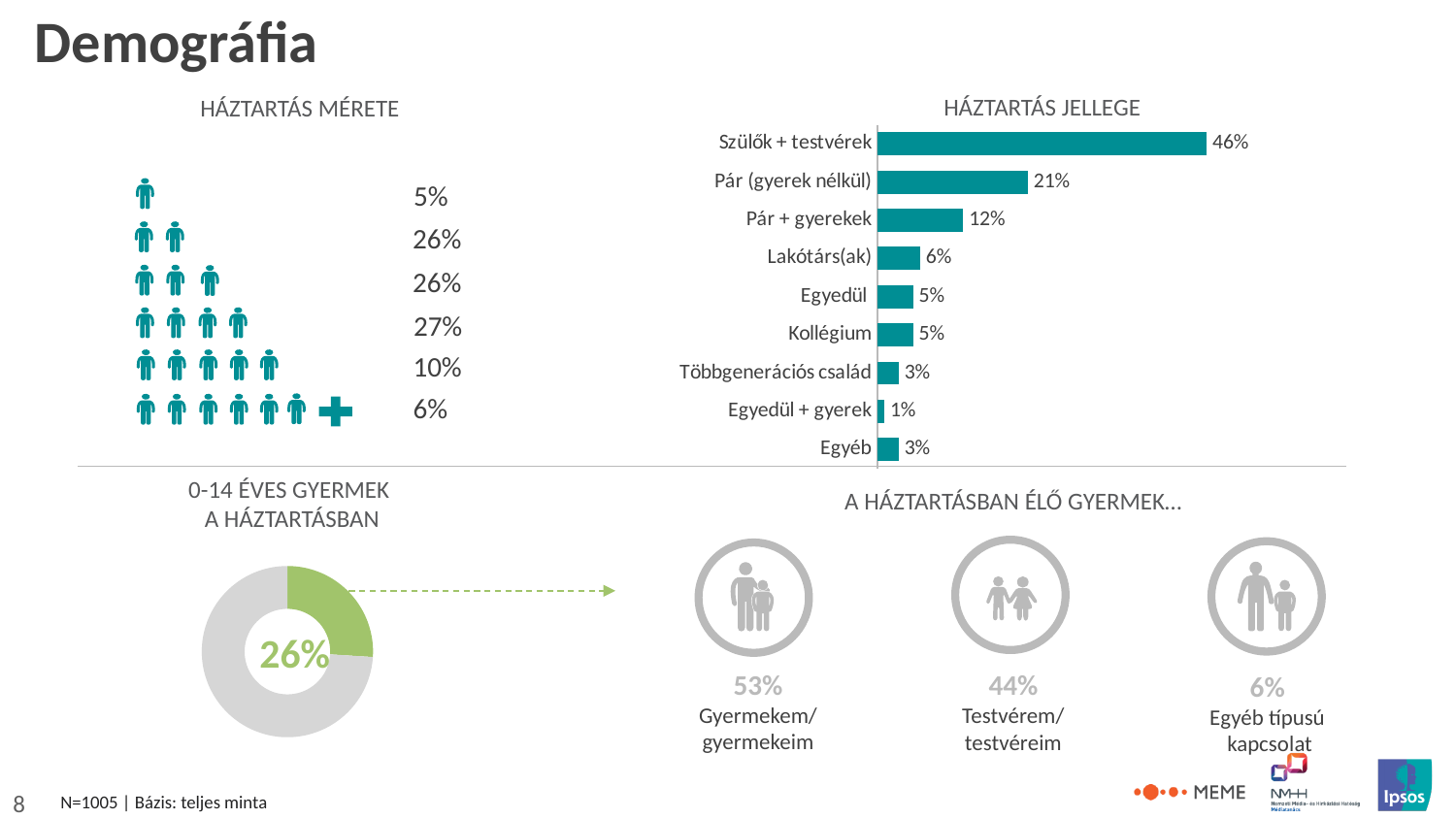
In the 'HÁZTARTÁS JELLEGE' chart, what is the value for 'Lakótárs(ak)'? 6% In the 'HÁZTARTÁS JELLEGE' chart, what is the value for 'Pár (gyerek nélkül)'? 21% In the 'HÁZTARTÁS JELLEGE' chart, what is the difference between 'Szülők + testvérek' and 'Pár (gyerek nélkül)'? 25% In the 'HÁZTARTÁS JELLEGE' chart, which category has the highest value? Szülők + testvérek What kind of chart is 'HÁZTARTÁS JELLEGE'? Bar chart In the 'HÁZTARTÁS JELLEGE' chart, which category has the lowest value? Egyedül + gyerek In the 'HÁZTARTÁS JELLEGE' chart, which is larger: 'Pár + gyerekek' or 'Lakótárs(ak)'? Pár + gyerekek How many categories are shown in the 'HÁZTARTÁS JELLEGE' chart? 9 In the 'A HÁZTARTÁSBAN ÉLŐ GYERMEK…' section, what is the value for 'Testvérem/testvéreim'? 44% In the 'HÁZTARTÁS MÉRETE' chart, what is the value for the four-person household? 27% In the '0-14 ÉVES GYERMEK A HÁZTARTÁSBAN' donut chart, what share is highlighted? 26% In the 'HÁZTARTÁS JELLEGE' chart, what is the value for 'Szülők + testvérek'? 46%